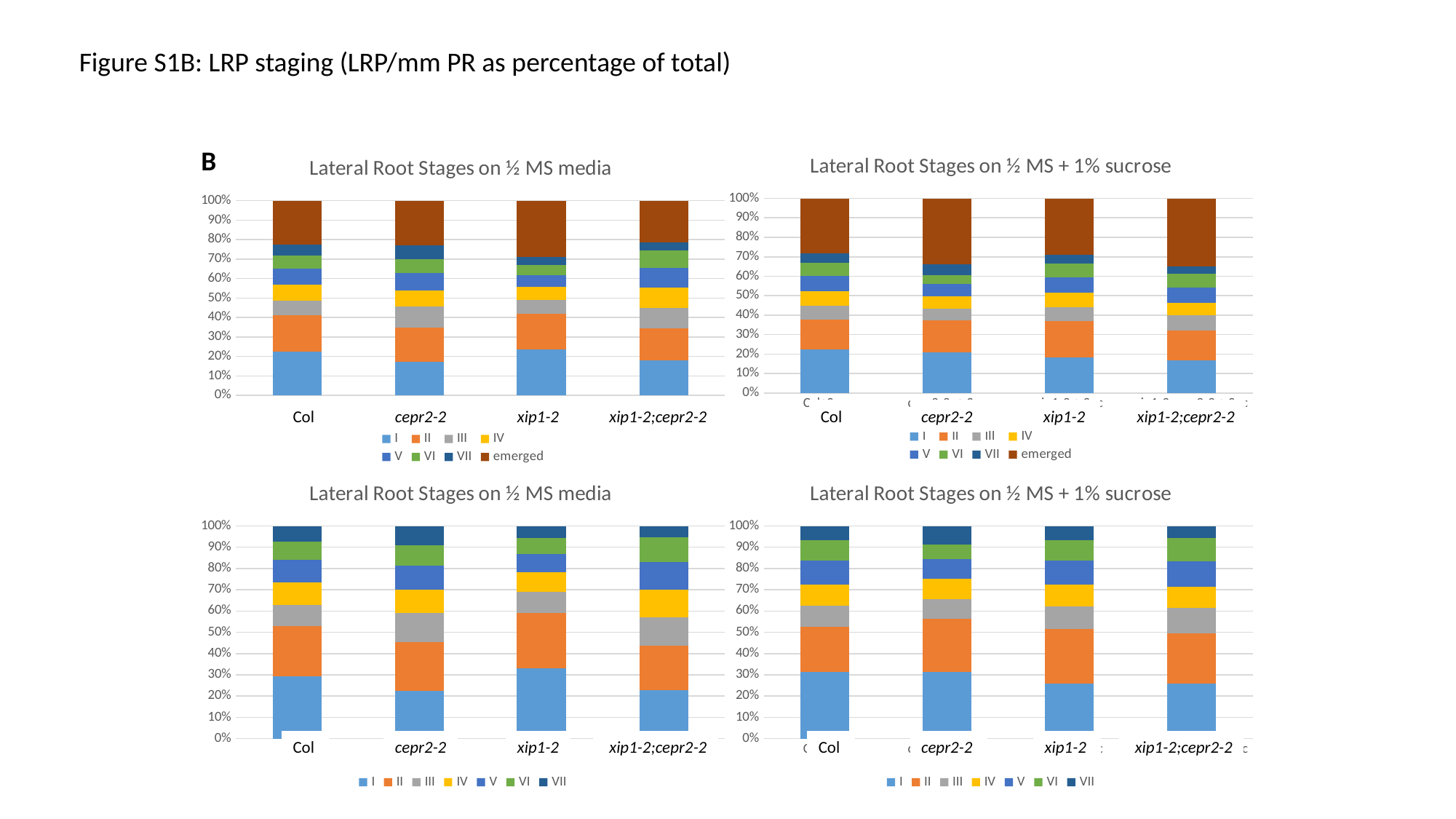
What kind of chart is the top-left chart titled 'Lateral Root Stages on ½ MS media'? Stacked bar chart Which legend entry appears in the top two charts but not in the bottom two charts? emerged How many series does the legend of the bottom-right chart list? 7 In the top-left chart, which has the larger stage I share, xip1-2 or cepr2-2? xip1-2 How many series does the legend of the top-left chart list? 8 In the bottom-left chart, which has the larger stage I share, Col or cepr2-2? Col What is the title of the top-right chart? Lateral Root Stages on ½ MS + 1% sucrose In the bottom-left chart, is the stage I share for xip1-2 greater or less than 30%? greater In the bottom-left chart, which genotype has the largest stage I share? xip1-2 How many genotype categories are shown on the x axis of the top-right chart 'Lateral Root Stages on ½ MS + 1% sucrose'? 4 In the top-left chart, is the stage I share for cepr2-2 greater or less than 20%? less In the bottom-right chart, is the stage I share for xip1-2 greater or less than 30%? less